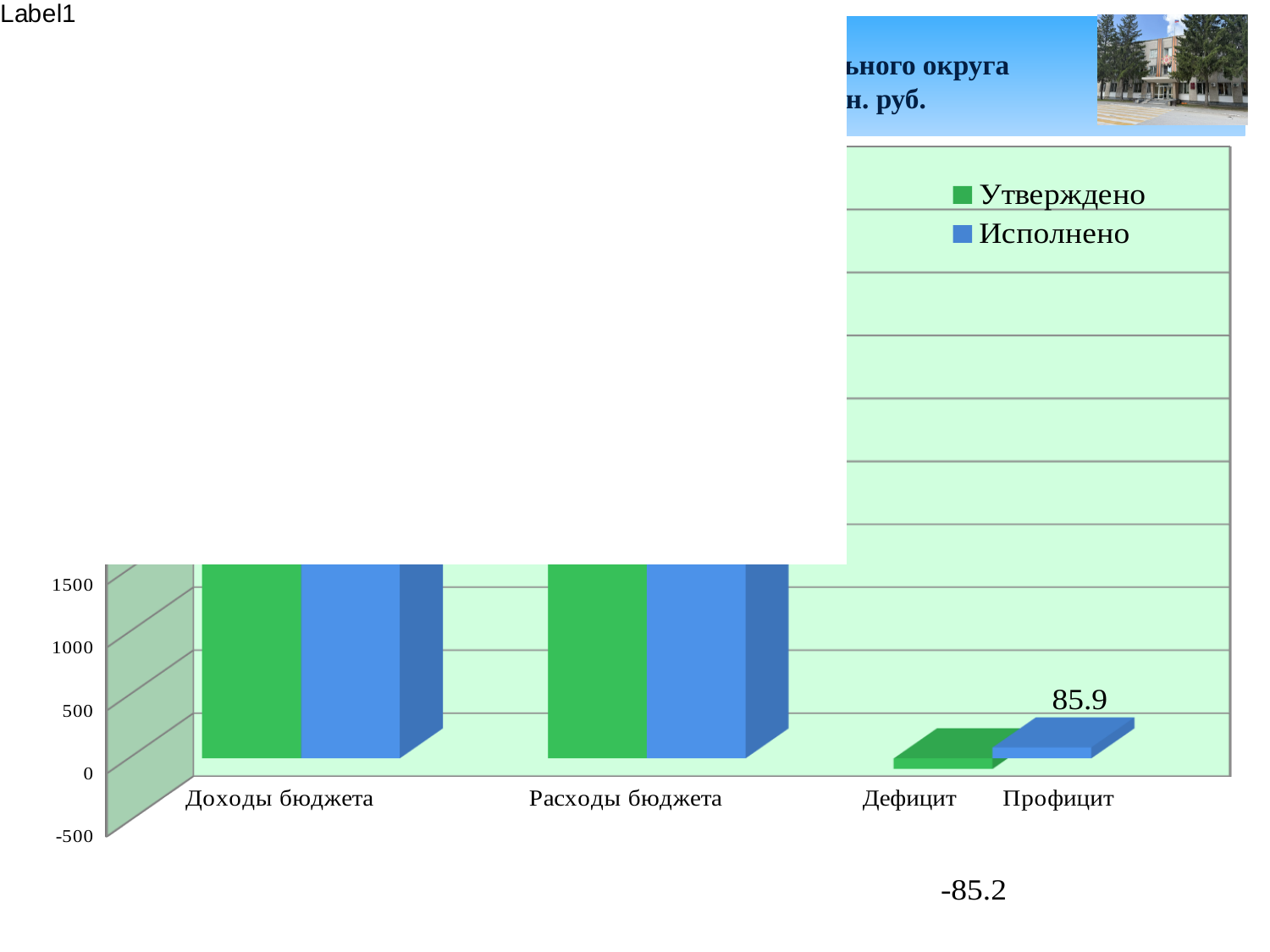
How many series does the legend list? 2 Is the Утверждено value for Доходы бюджета greater or less than 1000? greater Which colour represents the Утверждено series? green Is the Исполнено value for Расходы бюджета greater or less than 1000? greater What is the value printed for Исполнено in the Профицит category? 85.9 What are the two series named in the legend? Утверждено and Исполнено What type of chart is shown on the slide? bar chart Is the Исполнено value for Профицит greater or less than 500? less Which is larger: the Исполнено value for Доходы бюджета or the Исполнено value for Профицит? Доходы бюджета What is the lowest value shown on the vertical axis? -500